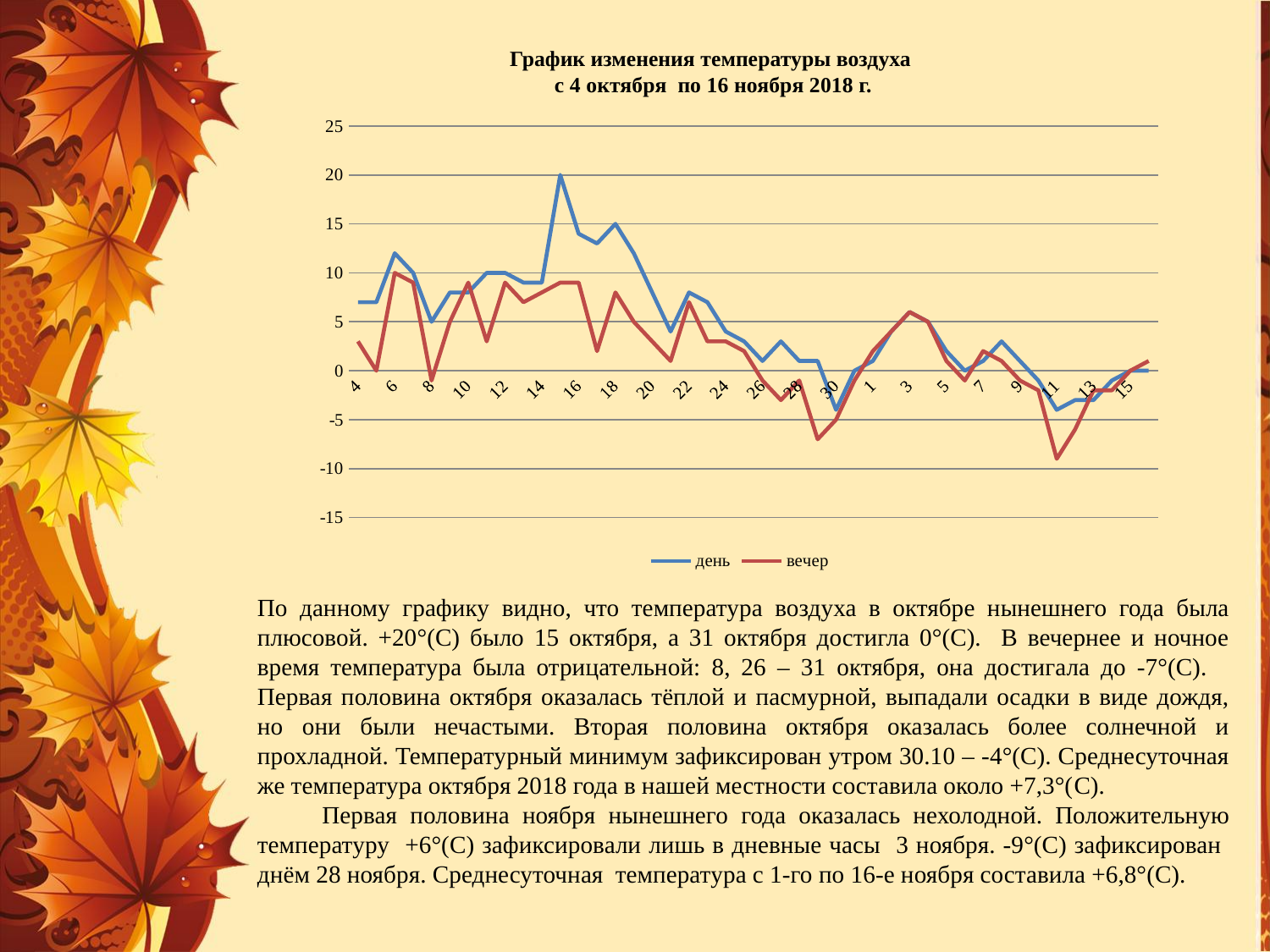
What is the lowest value shown on the vertical axis? -15 How many series does the legend list? 2 What kind of chart is shown on the slide? line chart Is the value of the вечер series on 11 (November) greater or less than -5? less On 8 (October), which series has the higher value, день or вечер? день What is the value of the день series on 15 (October)? 20 On which date does the день series reach its highest value? 15 (October) Does the день series rise or fall between 15 and 20 (October)? fall On 15 (October), which series has the higher value, день or вечер? день Which series reaches the lowest value on the chart? вечер What are the two series named in the legend? день and вечер